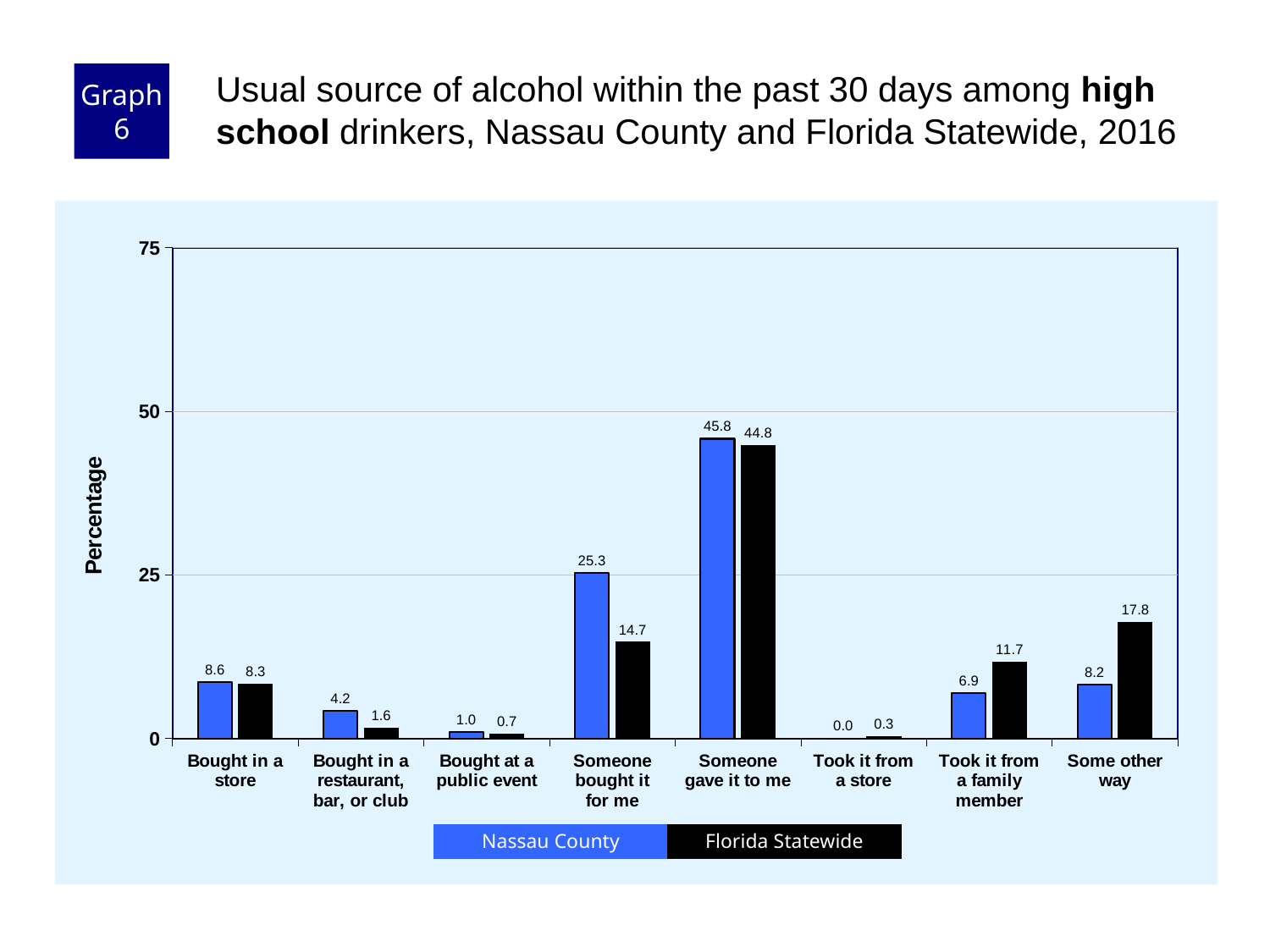
How many series does the legend list? 2 What is the Florida Statewide value for "Some other way"? 17.8 What is the difference between the Nassau County and Florida Statewide values for "Someone bought it for me"? 10.6 What is the Nassau County value for "Bought in a restaurant, bar, or club"? 4.2 What is the Nassau County value for "Someone gave it to me"? 45.8 What is the label of the y axis? Percentage What kind of chart is shown on the slide? Bar chart Which category has the highest Florida Statewide value? Someone gave it to me Is the Nassau County value for "Someone bought it for me" greater or less than 25? greater Which category has the lowest Nassau County value? Took it from a store How many categories are shown on the x axis? 8 Which is larger for "Took it from a family member": Nassau County or Florida Statewide? Florida Statewide